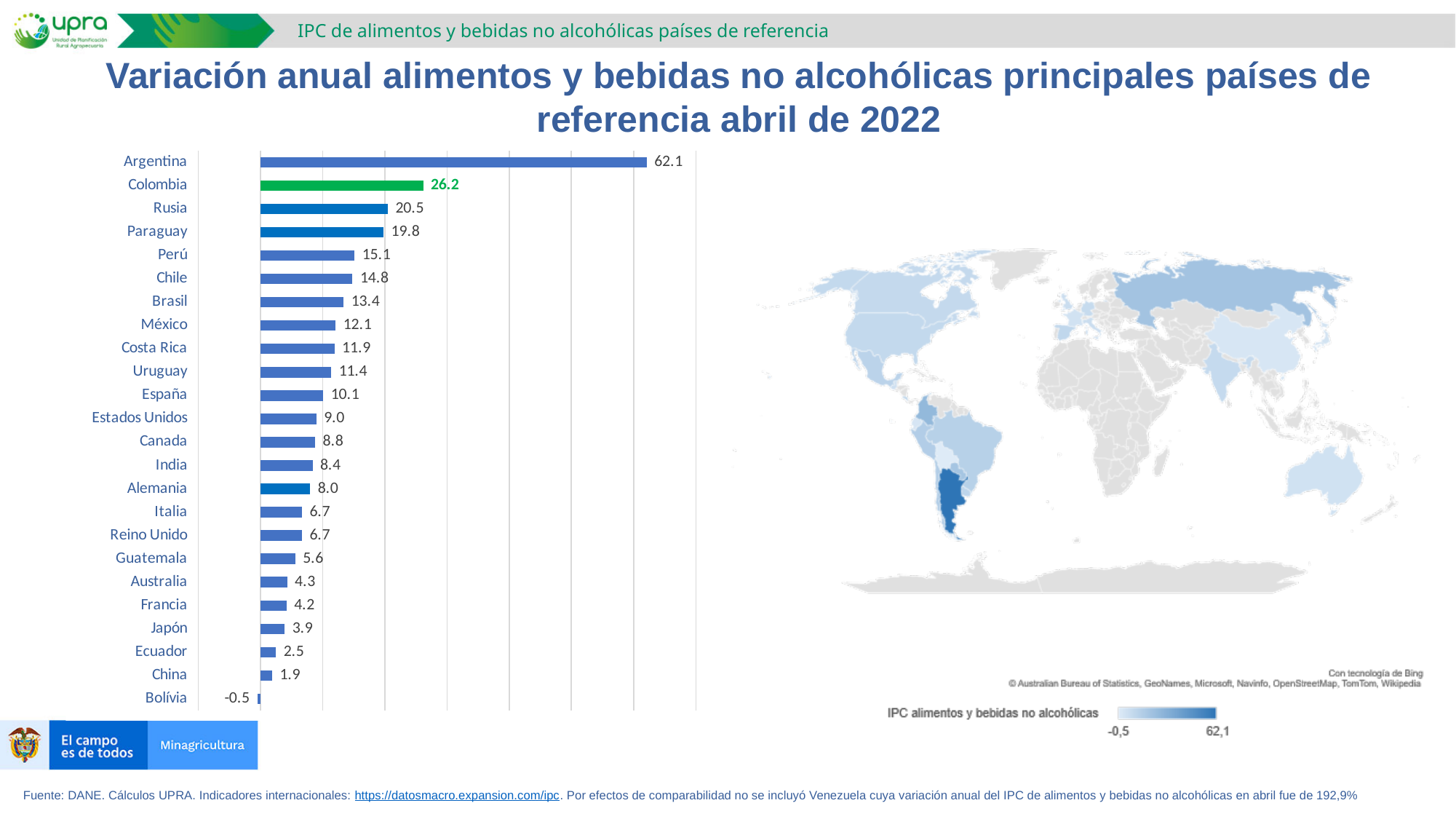
In the bar chart on the left, which has a larger value, Japón or Guatemala? Guatemala In the bar chart on the left, what is the value for Rusia? 20.5 In the bar chart on the left, what is the value for Bolívia? -0.5 In the bar chart on the left, which has a larger value, Paraguay or Brasil? Paraguay In the bar chart on the left, which country has the highest value? Argentina In the bar chart on the left, what is the value for Colombia? 26.2 In the bar chart on the left, which country has the lowest value? Bolívia In the bar chart on the left, what is the difference between the values for Argentina and Colombia? 35.9 In the bar chart on the left, what is the difference between the values for Perú and Chile? 0.3 In the bar chart on the left, which country's bar is coloured green? Colombia What kind of chart is shown on the left of the slide? Bar chart How many countries are shown in the bar chart on the left? 24